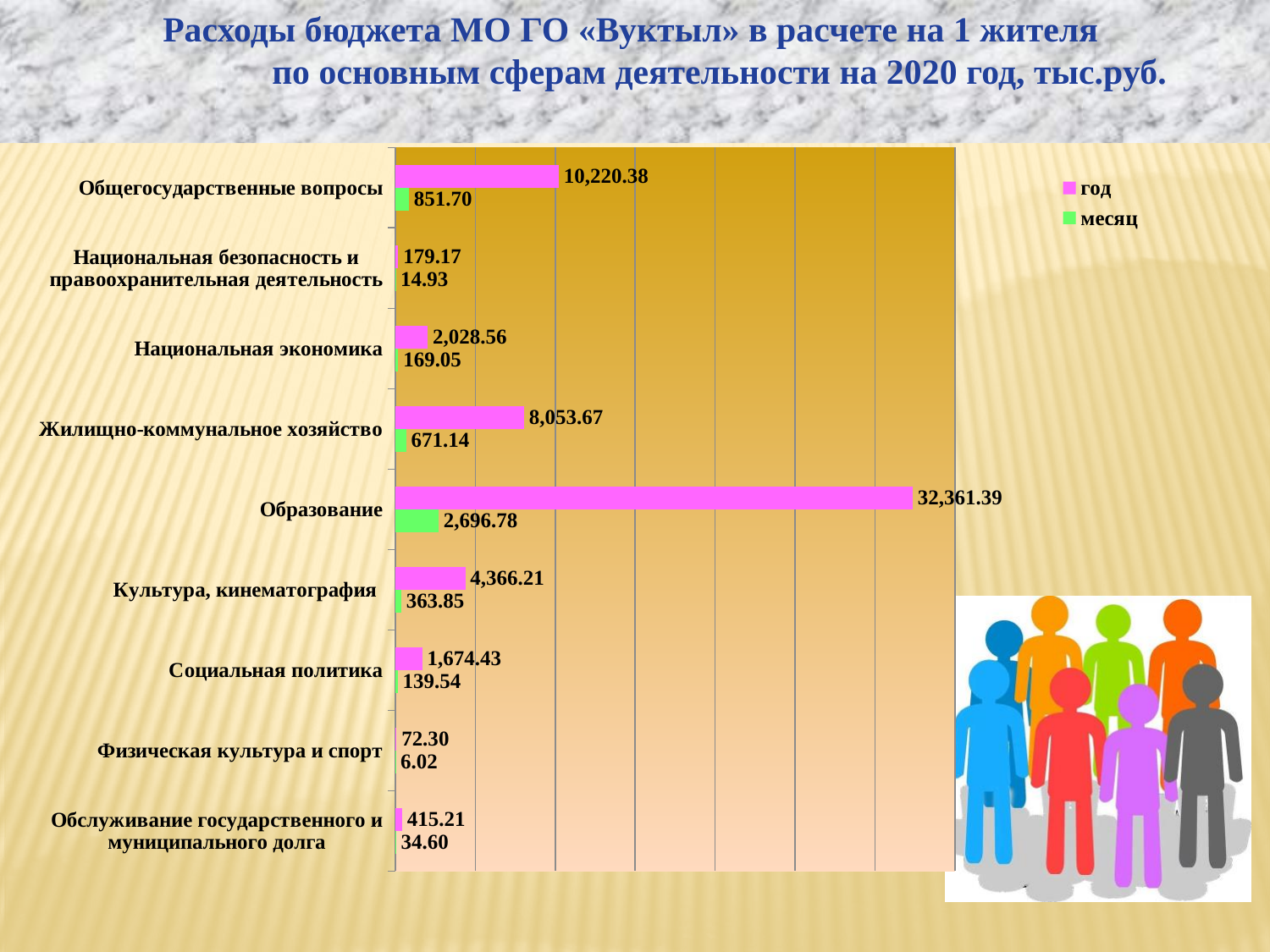
What is the "год" value for Культура, кинематография? 4,366.21 What are the two entries in the chart legend? год and месяц How many series does the legend list? 2 How many categories are shown on the chart? 9 What type of chart is shown on the slide? Bar chart What is the difference between the "год" and "месяц" values for Общегосударственные вопросы? 9,368.68 What is the value of the "месяц" series for Жилищно-коммунальное хозяйство? 671.14 What is the "месяц" value for Социальная политика? 139.54 Which category has the lowest "год" value? Физическая культура и спорт Which has a larger "год" value: Национальная экономика or Социальная политика? Национальная экономика What is the value of the "год" series for Образование? 32,361.39 Which category has the highest "год" value? Образование